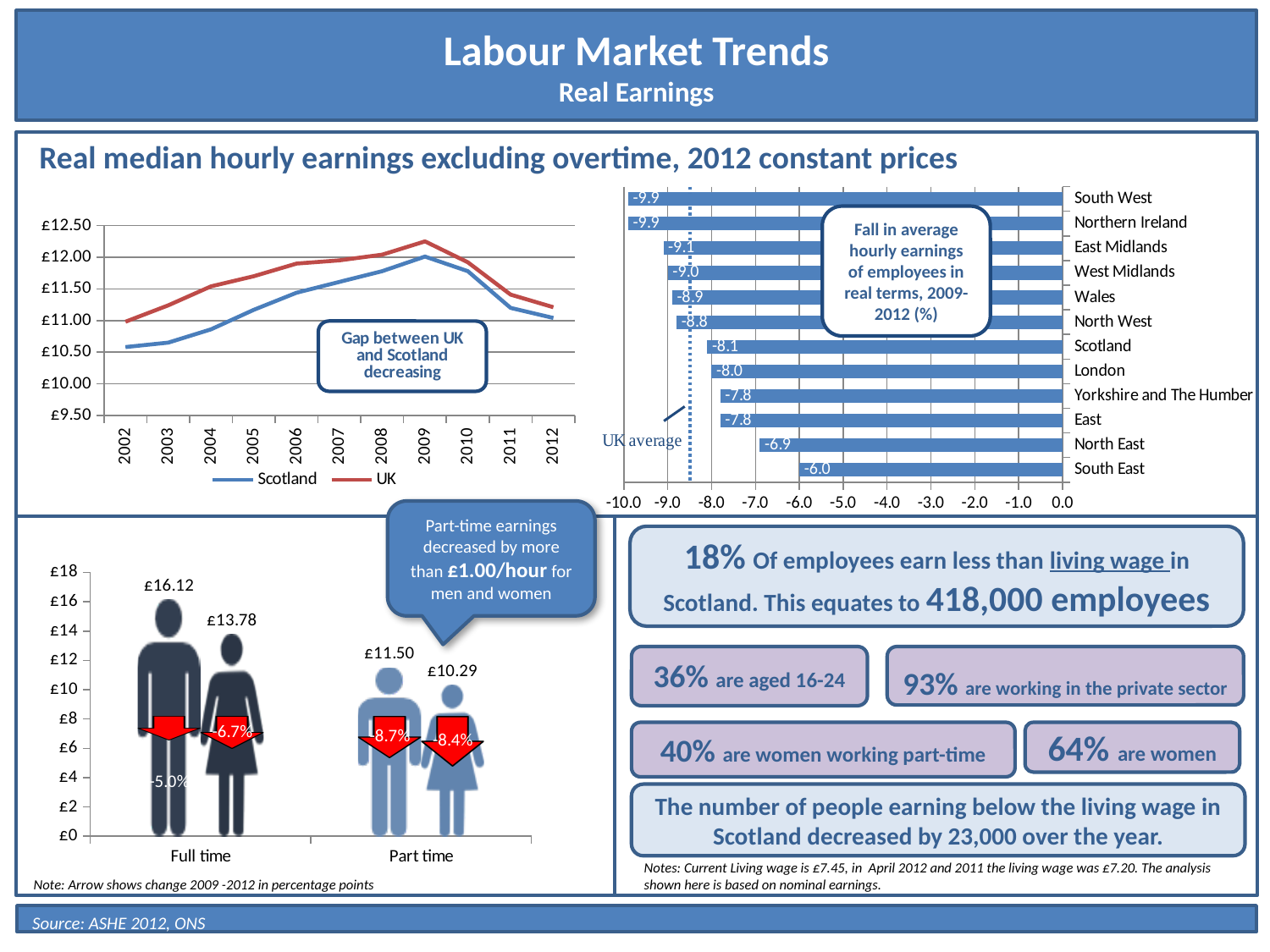
In the bar chart of the fall in average hourly earnings 2009-2012, what is the difference between the values for Scotland and South East? 2.1 In the line chart of real median hourly earnings, how many series does the legend list? 2 In the line chart of real median hourly earnings, is the value for UK in 2009 greater or less than £12.00? greater In the bottom-left chart of full time and part time earnings, what is the difference between the full time values for men and women? £2.34 In the bar chart of the fall in average hourly earnings 2009-2012, which region has the smallest fall? South East In the bottom-left chart of full time and part time earnings, what is the full time hourly earnings value for men? £16.12 What kind of chart is the top-right chart showing the fall in average hourly earnings by region? bar chart In the line chart of real median hourly earnings, which series is higher in 2002, Scotland or UK? UK In the bar chart of the fall in average hourly earnings 2009-2012, how many regions are shown? 12 In the line chart of real median hourly earnings, is the value for Scotland in 2002 greater or less than £11.00? less In the bar chart of the fall in average hourly earnings 2009-2012, what is the value for Scotland? -8.1 In the bar chart of the fall in average hourly earnings 2009-2012, what is the value for South East? -6.0